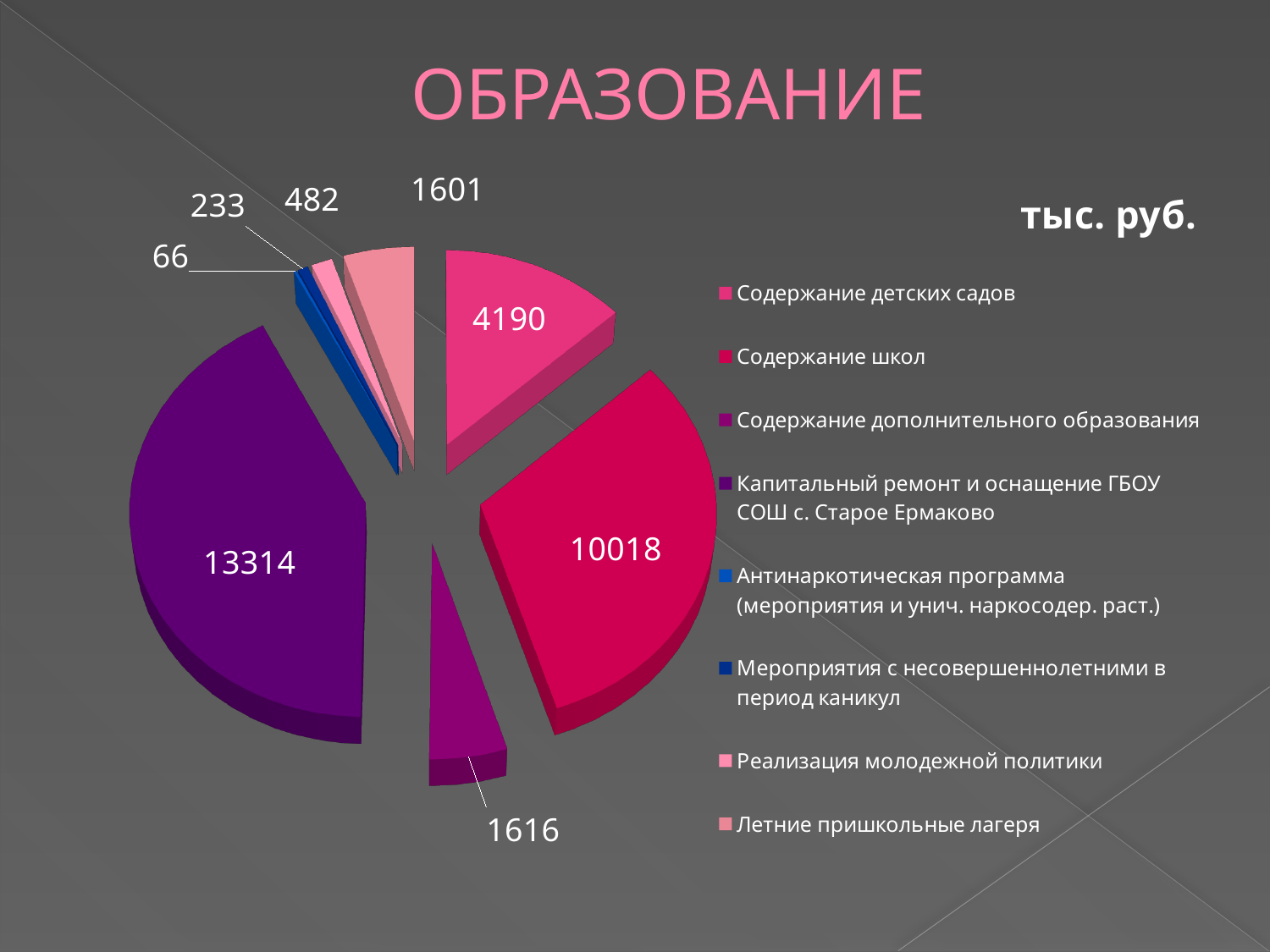
What kind of chart is shown on the slide? pie chart What is the title of the slide? ОБРАЗОВАНИЕ What is the difference between the values for Капитальный ремонт и оснащение ГБОУ СОШ с. Старое Ермаково and Содержание школ? 3296 What is the value for Летние пришкольные лагеря? 1601 What is the value for Содержание школ? 10018 What is the value for Капитальный ремонт и оснащение ГБОУ СОШ с. Старое Ермаково? 13314 Which is larger: the value for Содержание дополнительного образования or the value for Летние пришкольные лагеря? Содержание дополнительного образования In what units are the values on the chart given? тыс. руб. How many categories does the legend list? 8 Which category has the largest slice of the pie? Капитальный ремонт и оснащение ГБОУ СОШ с. Старое Ермаково What is the value for Содержание детских садов? 4190 Which category has the smallest slice of the pie? Антинаркотическая программа (мероприятия и унич. наркосодер. раст.)